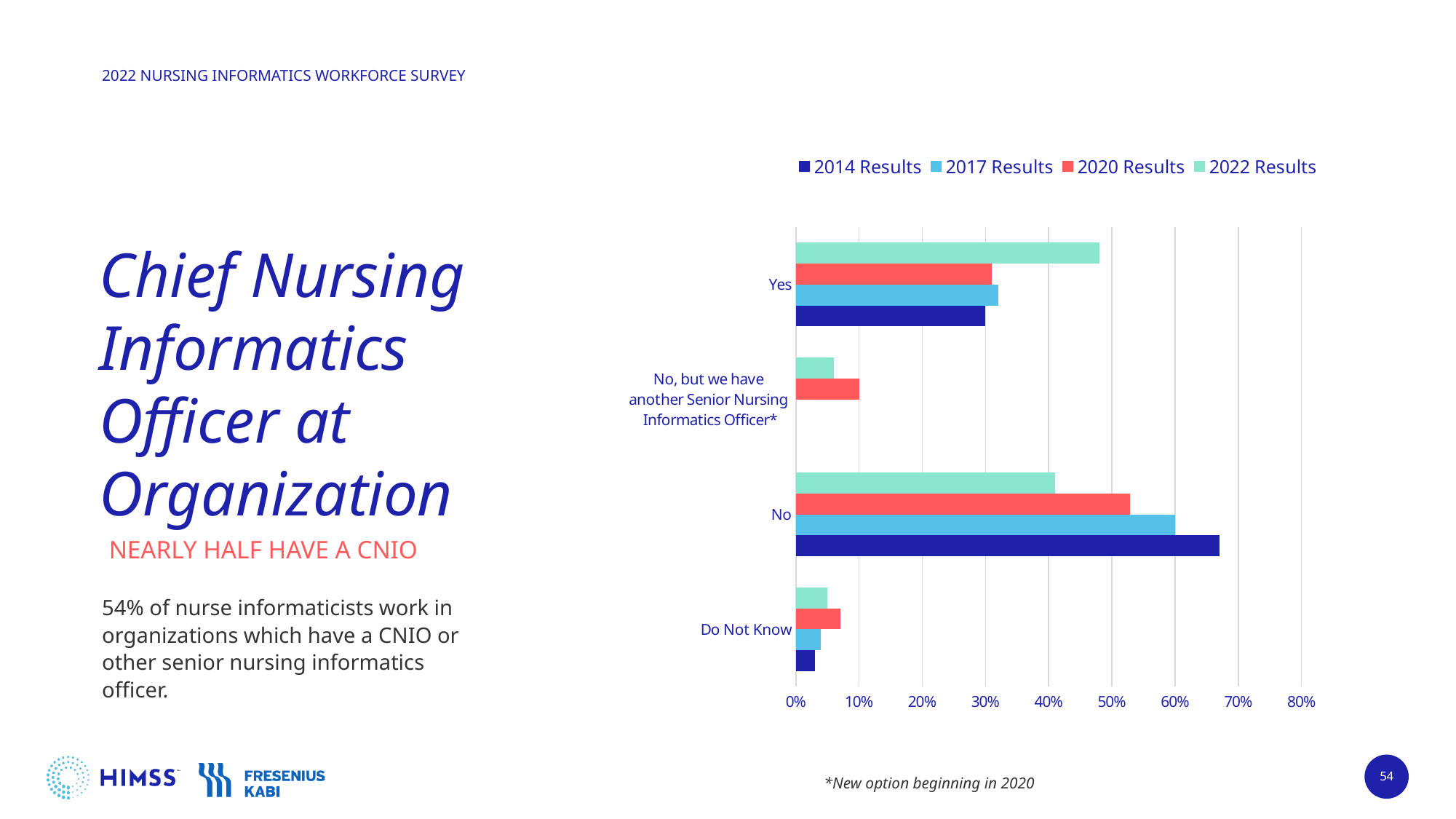
What kind of chart is shown on the slide? bar chart Is the 2022 Results value for "Yes" greater or less than 40%? greater For the "No" category, which is larger: the 2014 Results value or the 2022 Results value? 2014 Results Is the 2022 Results value for "No, but we have another Senior Nursing Informatics Officer" greater or less than 10%? less Which response category has the highest 2014 Results value? No Which survey year has the lowest value for the "No" category? 2022 Results From 2014 Results to 2022 Results, do the bars for the "No" category get longer or shorter? shorter How many response categories are shown on the chart? 4 Is the 2014 Results value for "No" greater or less than 60%? greater For the "Yes" category, which is larger: the 2022 Results value or the 2020 Results value? 2022 Results How many series does the legend list? 4